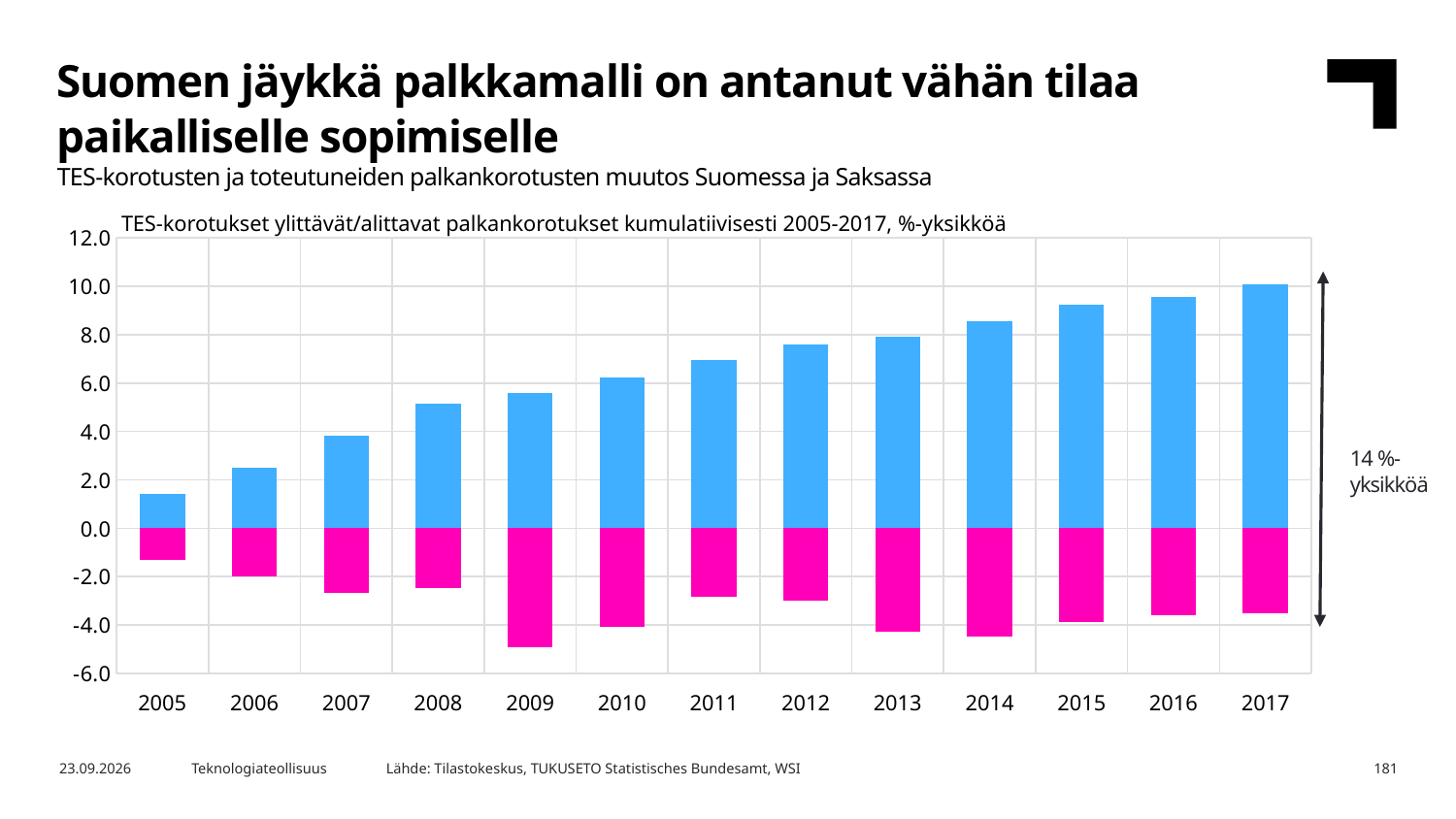
Which year has the shortest blue (positive) bar? 2005 Is the value of the blue bar for 2017 greater or less than 8.0? greater Do the blue (positive) bars rise or fall from 2005 to 2017? rise Is the value of the magenta bar for 2009 greater or less than -4.0? less Which year has the longest magenta (negative) bar? 2009 Is the value of the blue bar for 2008 greater or less than 4.0? greater Which year has the tallest blue (positive) bar? 2017 How many years are shown on the x axis of the chart? 13 Which year has the larger blue bar, 2005 or 2017? 2017 What kind of chart is shown on the slide? bar chart What value is written in the annotation next to the arrow on the right side of the chart? 14 %-yksikköä